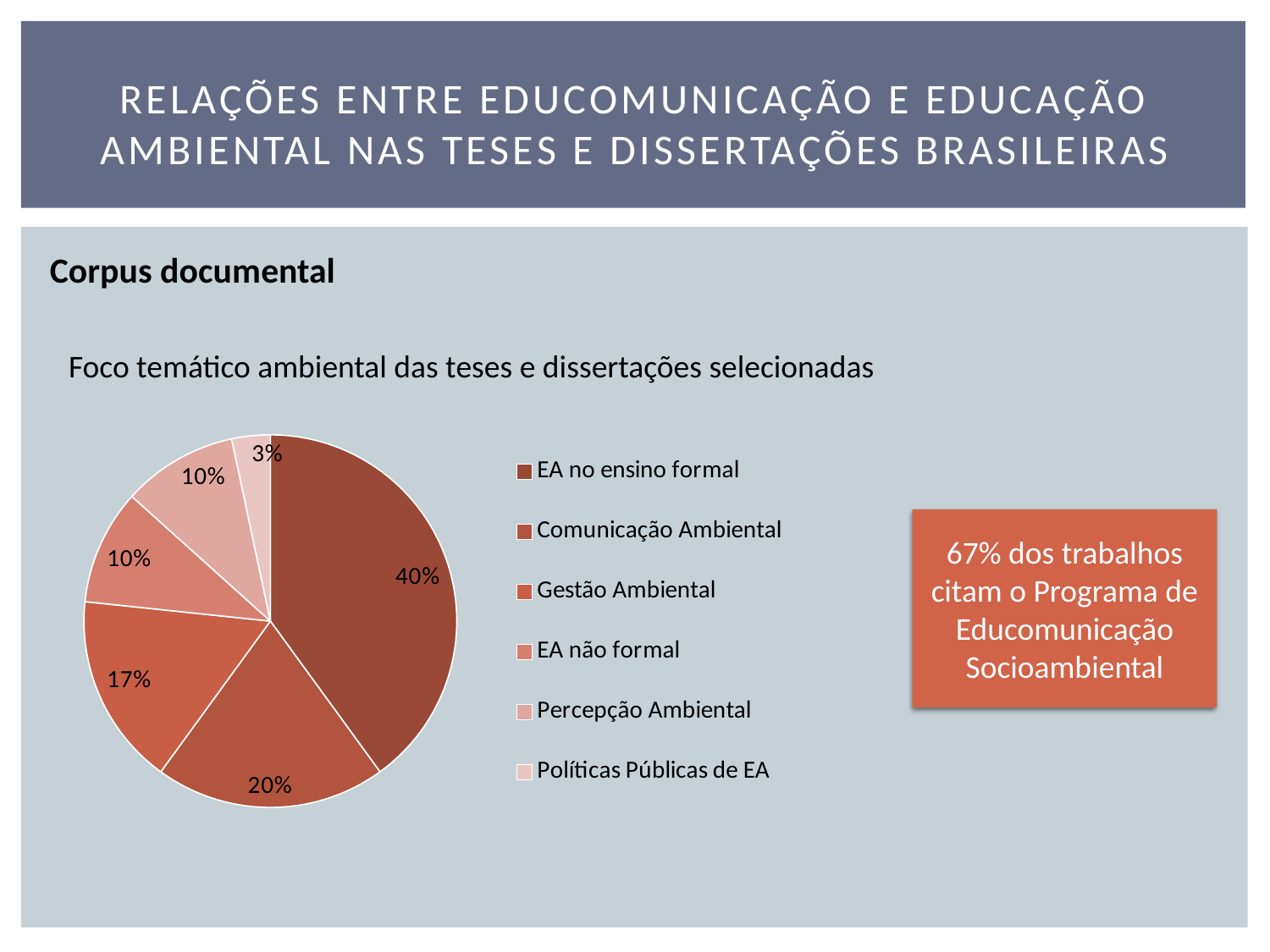
What share of the pie does "Comunicação Ambiental" represent? 20% What share of the pie does "EA no ensino formal" represent? 40% Which is larger, the slice for "Gestão Ambiental" or the slice for "EA não formal"? Gestão Ambiental How many categories does the pie chart have? 6 What share of the pie does "Políticas Públicas de EA" represent? 3% Which category has the smallest slice of the pie? Políticas Públicas de EA How many entries does the legend of the pie chart list? 6 Which category has the largest slice of the pie? EA no ensino formal What is the difference in percentage points between "Gestão Ambiental" and "Percepção Ambiental"? 7 What is the difference in percentage points between "EA no ensino formal" and "Comunicação Ambiental"? 20 What kind of chart is shown on the slide? pie chart